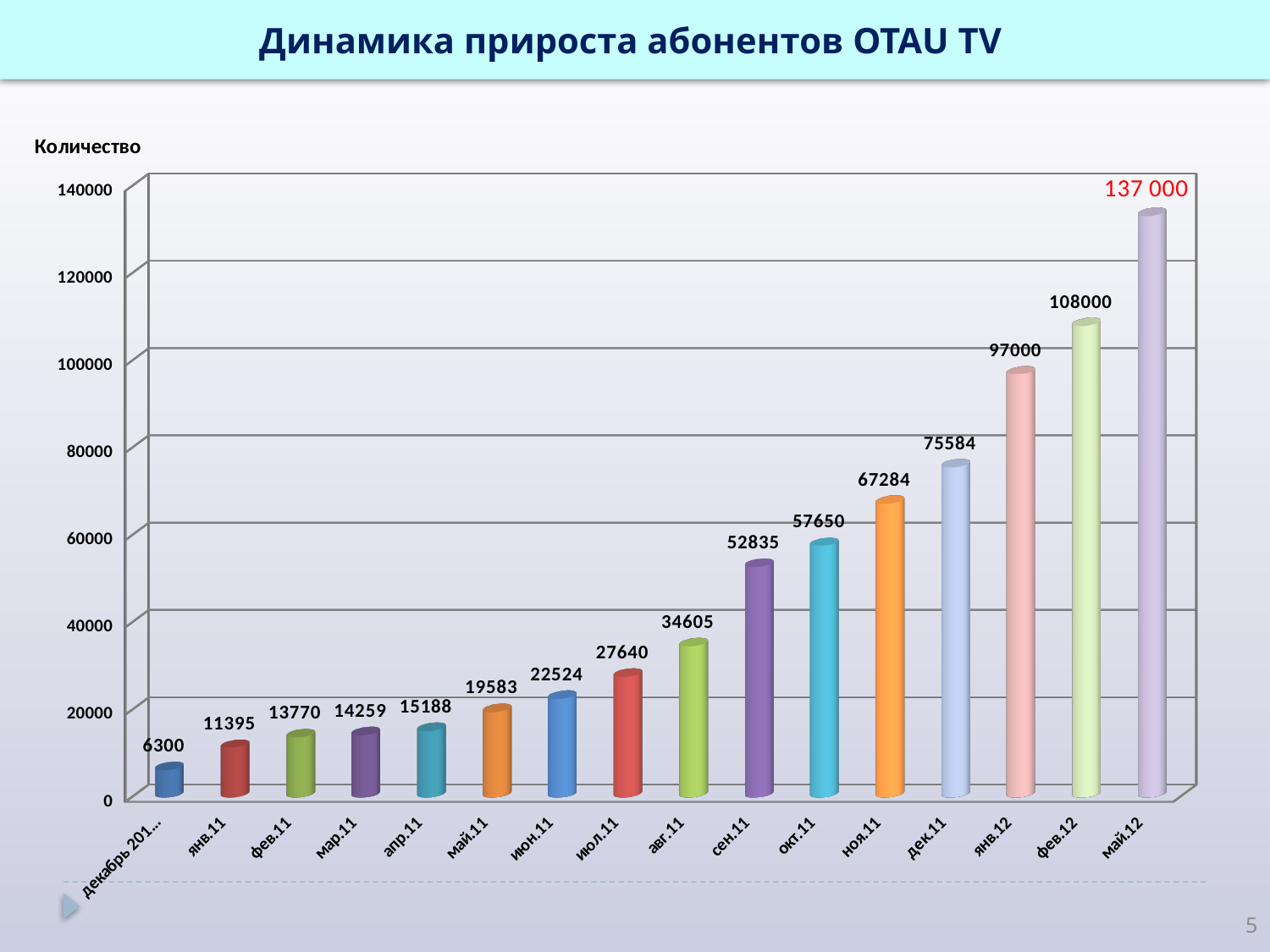
Which month has the highest value? май.12 What is the value for дек.11? 75584 Do the values rise or fall from left to right along the x axis? rise What is the value for сен.11? 52835 What is the difference between the values for май.12 and фев.12? 29000 Which is larger, the value for окт.11 or the value for ноя.11? ноя.11 What is the difference between the values for янв.12 and дек.11? 21416 What kind of chart is shown on the slide? bar chart Is the value for авг.11 greater or less than 40000? less How many bars are shown in the chart? 16 What is the value for апр.11? 15188 What is the value for май.12? 137 000